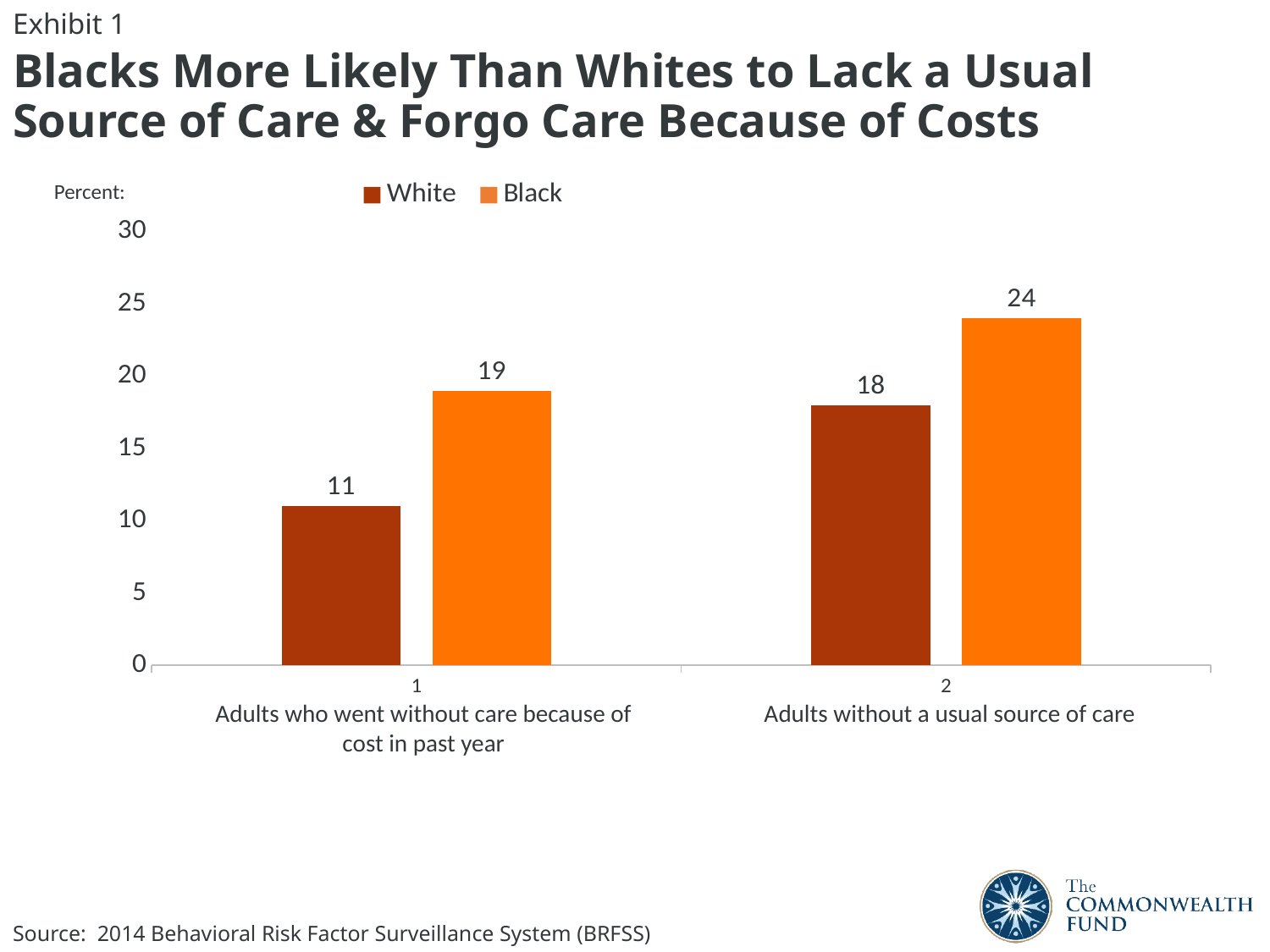
Which is larger: the White value for adults without a usual source of care or the Black value for adults who went without care because of cost in past year? Black value for adults who went without care because of cost in past year What is the difference between the Black and White values for adults without a usual source of care? 6 What is the value for White adults without a usual source of care? 18 What is the value for White adults who went without care because of cost in past year? 11 How many series does the legend list? 2 Which bar has the highest value on the chart? Black, adults without a usual source of care Which bar has the lowest value on the chart? White, adults who went without care because of cost in past year What unit is the vertical axis labeled with? Percent What kind of chart is shown on the slide? Bar chart What is the value for Black adults who went without care because of cost in past year? 19 What is the difference between the Black and White values for adults who went without care because of cost in past year? 8 What is the value for Black adults without a usual source of care? 24